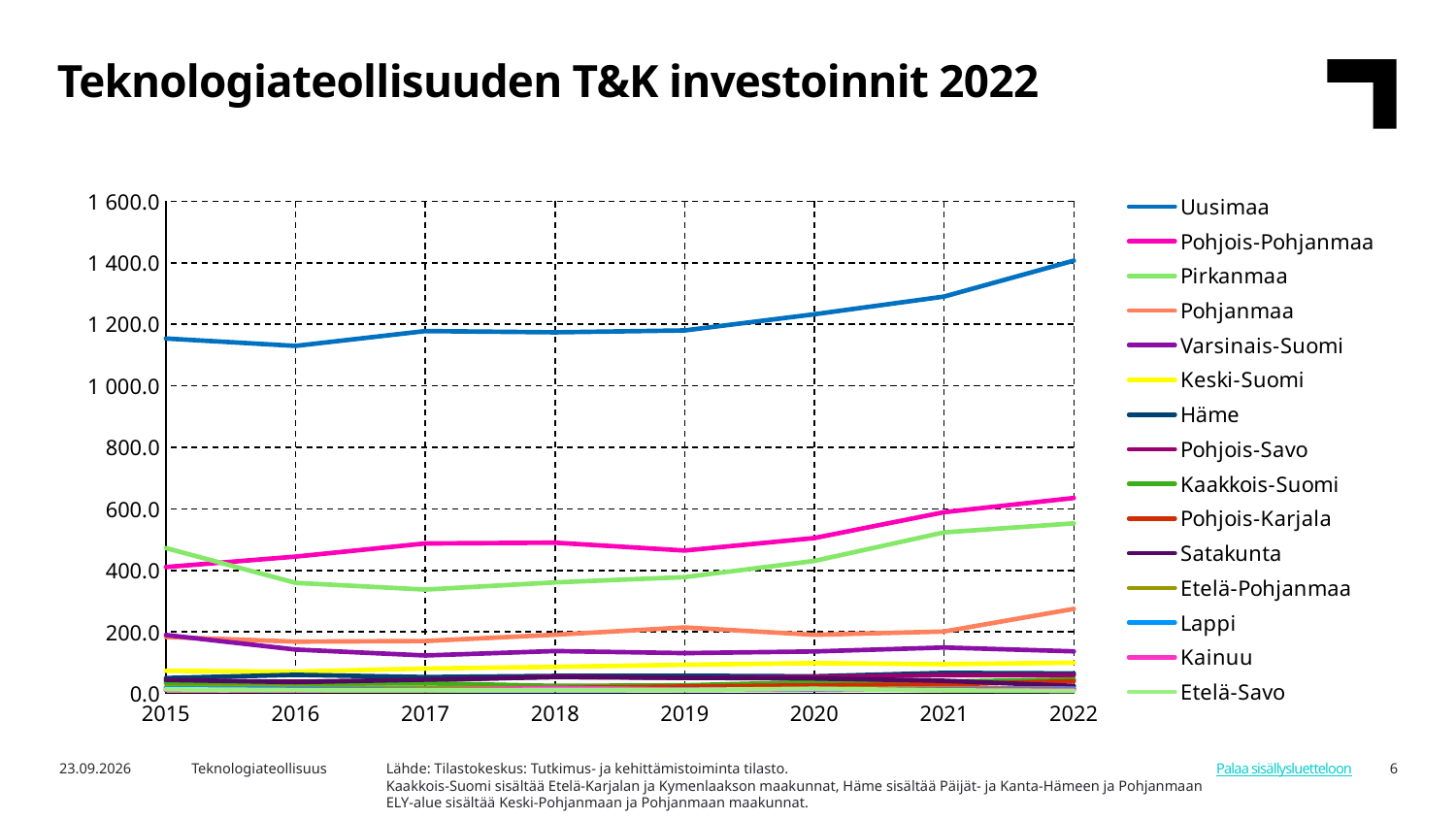
Is the value for Pohjanmaa in 2022 greater or less than 200.0? greater Is the value for Uusimaa in 2015 greater or less than 1 000.0? greater Which is higher in 2015, Pirkanmaa or Pohjois-Pohjanmaa? Pirkanmaa Which series has the highest value in 2022? Uusimaa Is the value for Uusimaa in 2016 greater or less than 1 200.0? less How many series does the legend list? 15 How many years are shown on the x axis? 8 Does the value for Uusimaa rise or fall from 2019 to 2022? rise What kind of chart is shown on the slide? line chart What is the title of the chart? Teknologiateollisuuden T&K investoinnit 2022 Which is higher in 2022, Pohjois-Pohjanmaa or Pirkanmaa? Pohjois-Pohjanmaa